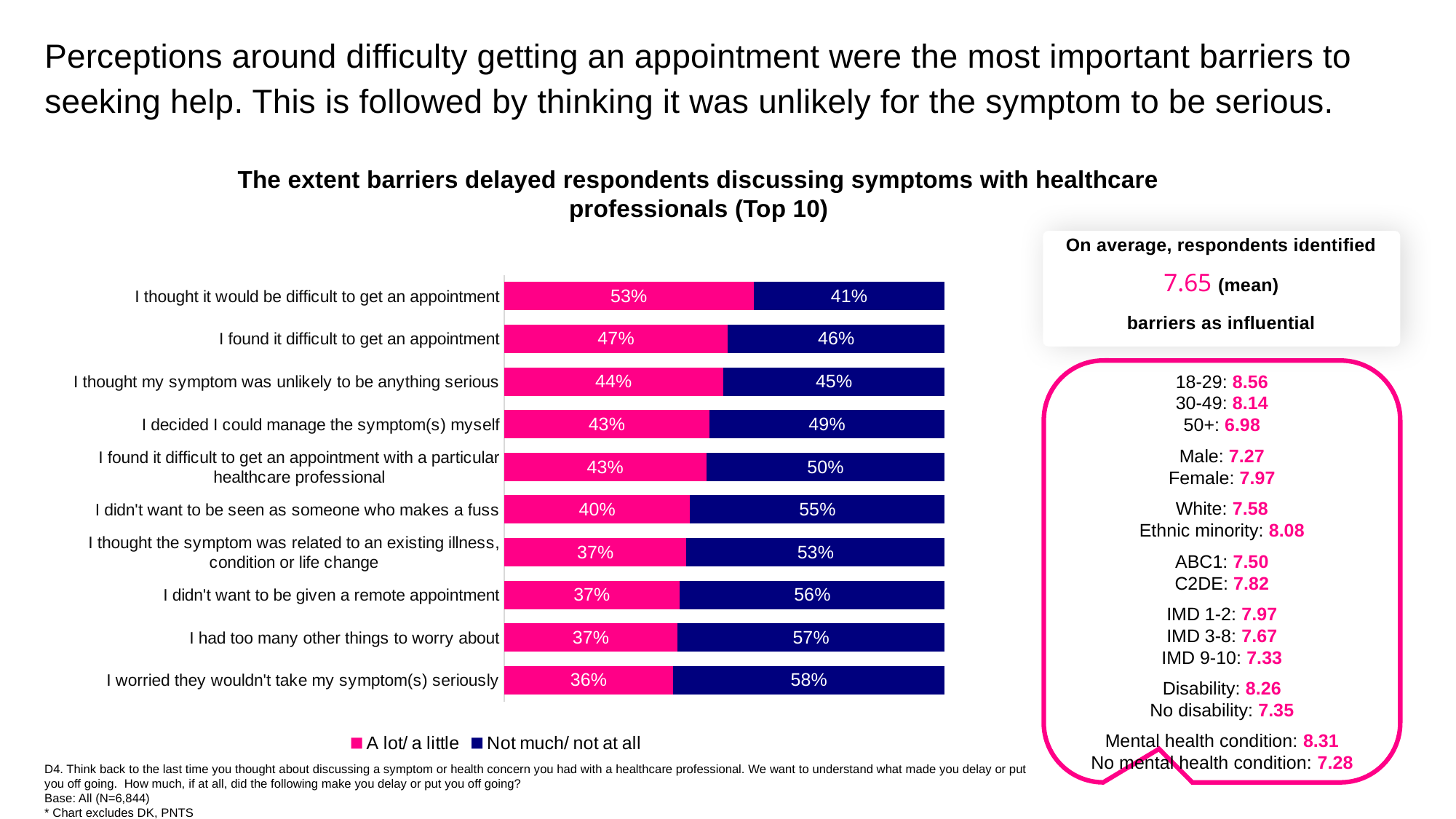
Which barrier has the lowest 'A lot/ a little' percentage? I worried they wouldn't take my symptom(s) seriously What percentage of respondents said 'I thought it would be difficult to get an appointment' delayed them a lot/a little? 53% For 'I found it difficult to get an appointment', which is larger: 'A lot/ a little' or 'Not much/ not at all'? A lot/ a little What type of chart is shown on the slide? Stacked bar chart Which colour represents 'Not much/ not at all' in the chart? Dark blue What is the 'Not much/ not at all' value for 'I worried they wouldn't take my symptom(s) seriously'? 58% What is the combined total of the two segments for 'I had too many other things to worry about'? 94% What is the difference between the 'A lot/ a little' and 'Not much/ not at all' values for 'I decided I could manage the symptom(s) myself'? 6 percentage points How many barriers are shown in the chart? 10 How many series does the legend list? 2 What is the 'A lot/ a little' value for 'I didn't want to be seen as someone who makes a fuss'? 40% Which barrier has the highest 'A lot/ a little' percentage? I thought it would be difficult to get an appointment